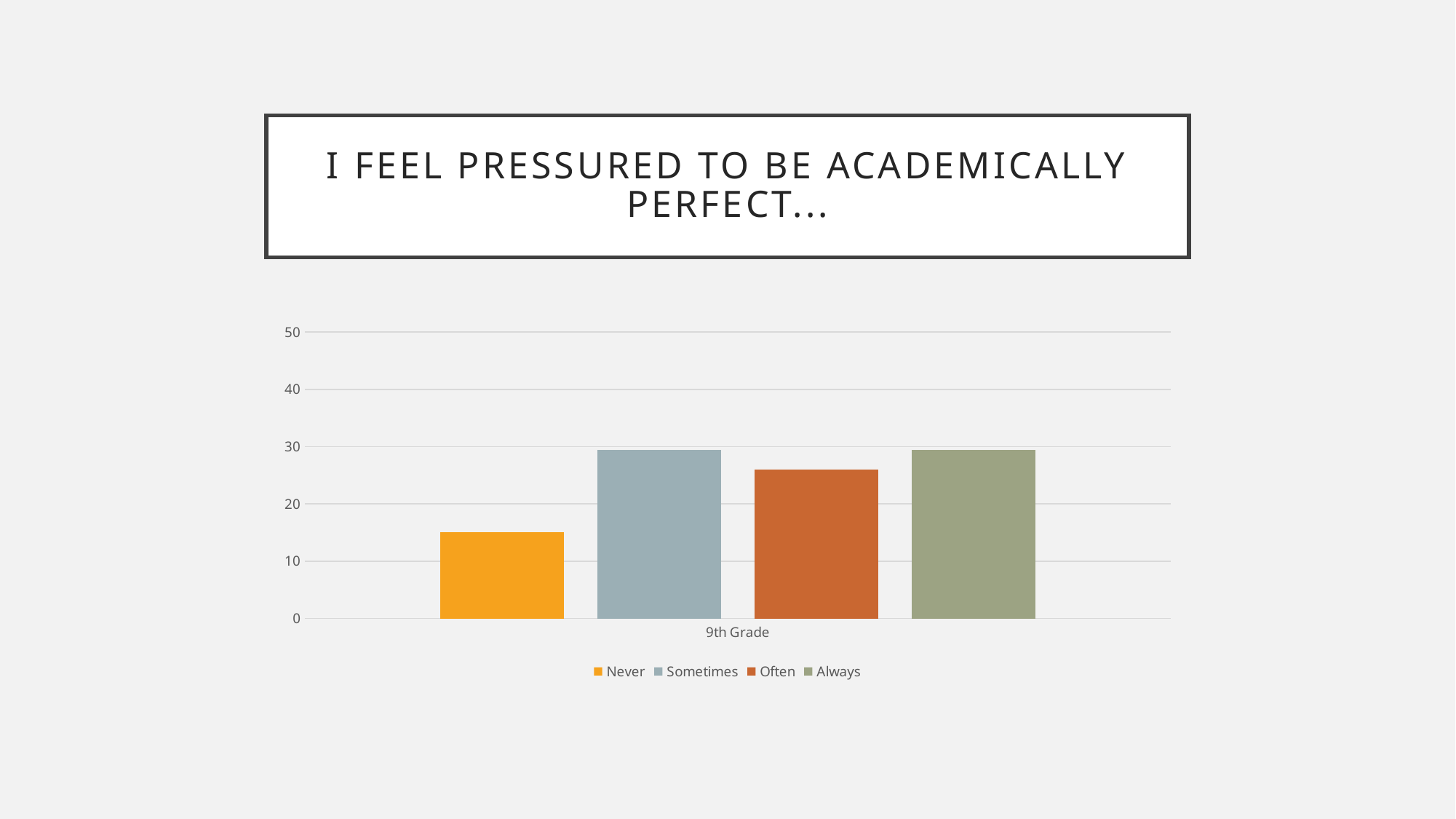
Is the value for Never greater or less than 10? greater Which series has the lowest value for 9th Grade? Never What kind of chart is shown on the slide? bar chart Which is larger for 9th Grade, Sometimes or Often? Sometimes How many categories are shown on the x axis? 1 How many series does the legend list? 4 What is the title of the slide? I FEEL PRESSURED TO BE ACADEMICALLY PERFECT... Is the value for Always greater or less than 20? greater Is the value for Never greater or less than 20? less Which is larger for 9th Grade, Never or Often? Often